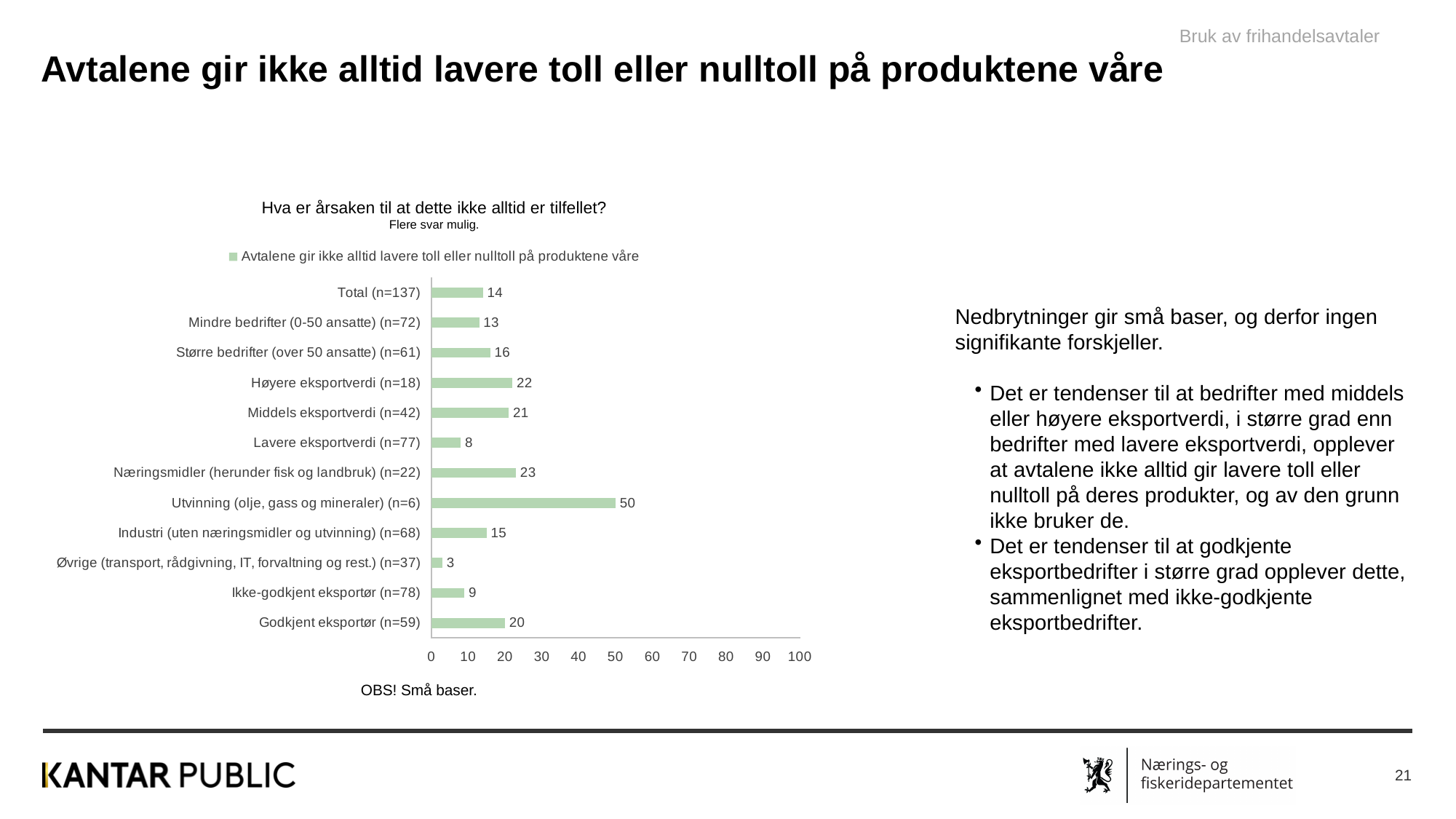
What is the value for Total (n=137)? 14 How many categories are shown in the chart? 12 What is the value for Utvinning (olje, gass og mineraler) (n=6)? 50 Which is larger, the value for Høyere eksportverdi (n=18) or Middels eksportverdi (n=42)? Høyere eksportverdi (n=18) Which category has the lowest value? Øvrige (transport, rådgivning, IT, forvaltning og rest.) (n=37) Which category has the highest value? Utvinning (olje, gass og mineraler) (n=6) What kind of chart is shown on the slide? bar chart What is the value for Lavere eksportverdi (n=77)? 8 How many series does the legend list? 1 What is the difference between the values for Godkjent eksportør (n=59) and Ikke-godkjent eksportør (n=78)? 11 What is the maximum value shown on the x axis? 100 Is the value for Næringsmidler (herunder fisk og landbruk) (n=22) greater or less than 30? less